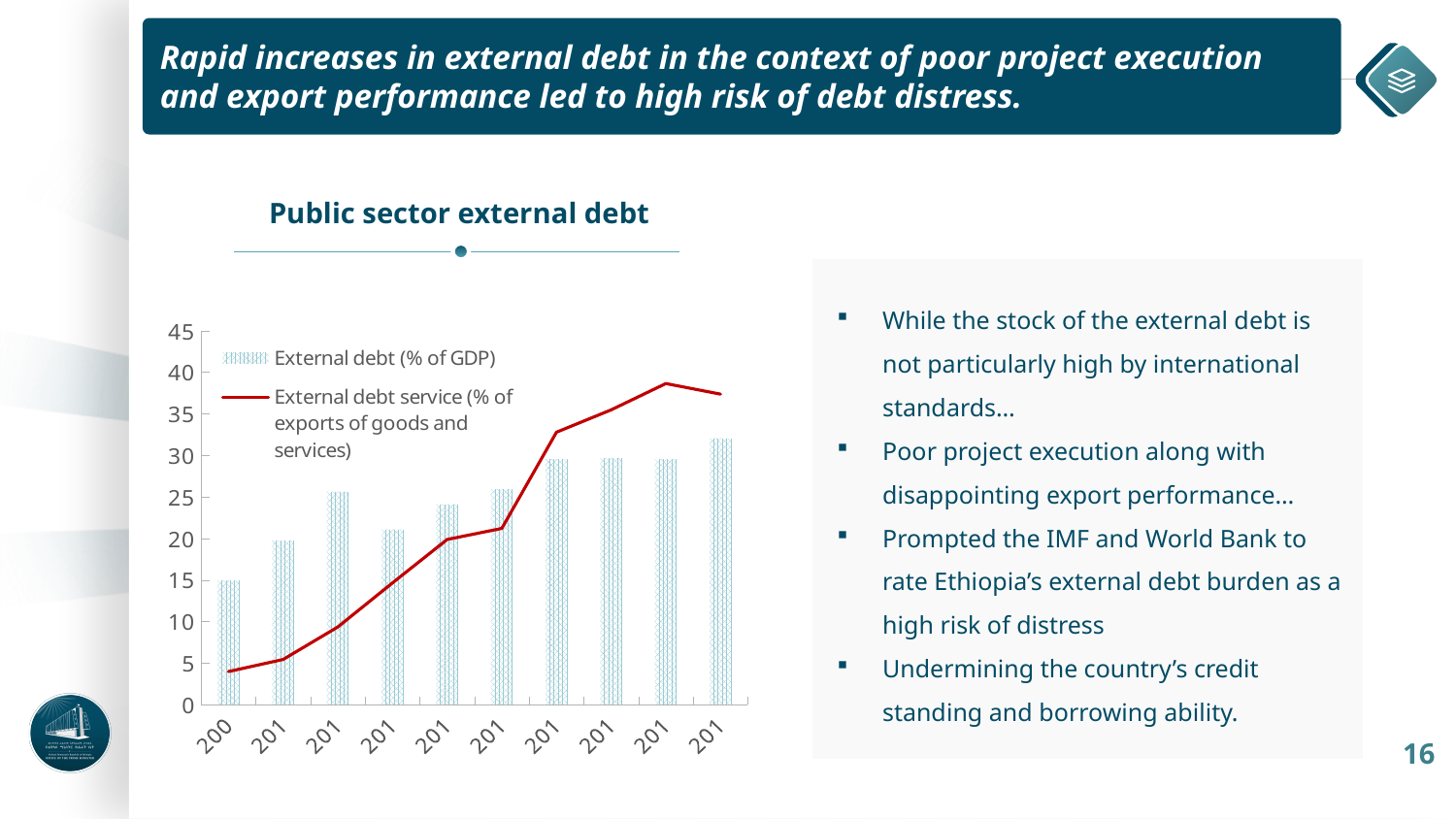
What is the maximum value shown on the chart's vertical axis? 45 How many series does the chart's legend list? 2 Is the value of the last (rightmost) External debt (% of GDP) bar greater or less than 30? greater Does the External debt service (% of exports of goods and services) line generally rise or fall from left to right? Rise Which bar is the lowest for External debt (% of GDP): the first bar or the last bar? The first bar How many bars are plotted in the chart? 10 What kind of chart is shown on the slide? Combined bar and line chart What is the title of the chart on the slide? Public sector external debt Which series is plotted as bars in the chart? External debt (% of GDP) Is the value of the first (leftmost) External debt (% of GDP) bar greater or less than 20? less Is the first (leftmost) point of the External debt service line greater or less than 5? less